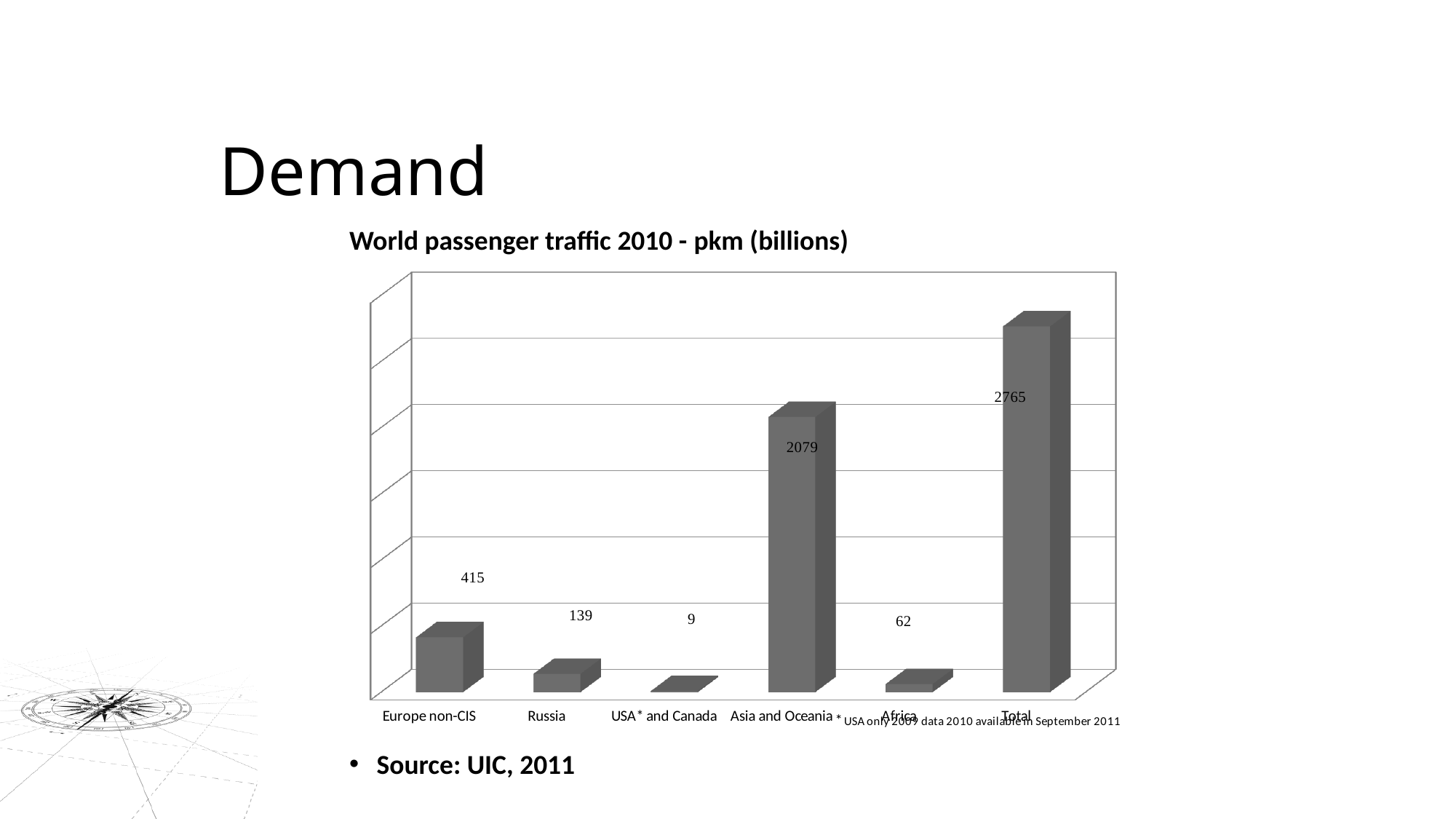
What is the value for Europe non-CIS? 415 How many categories are shown on the x axis? 6 What is the difference between the values for Europe non-CIS and Russia? 276 What is the value for USA* and Canada? 9 What is the value for Russia? 139 Which category has the lowest value? USA* and Canada What is the title of the chart? World passenger traffic 2010 - pkm (billions) What is the value for Africa? 62 Which is larger, the value for Russia or the value for Africa? Russia Excluding the Total bar, which region has the highest value? Asia and Oceania What kind of chart is shown on the slide? Bar chart What is the value for Asia and Oceania in the World passenger traffic 2010 chart? 2079